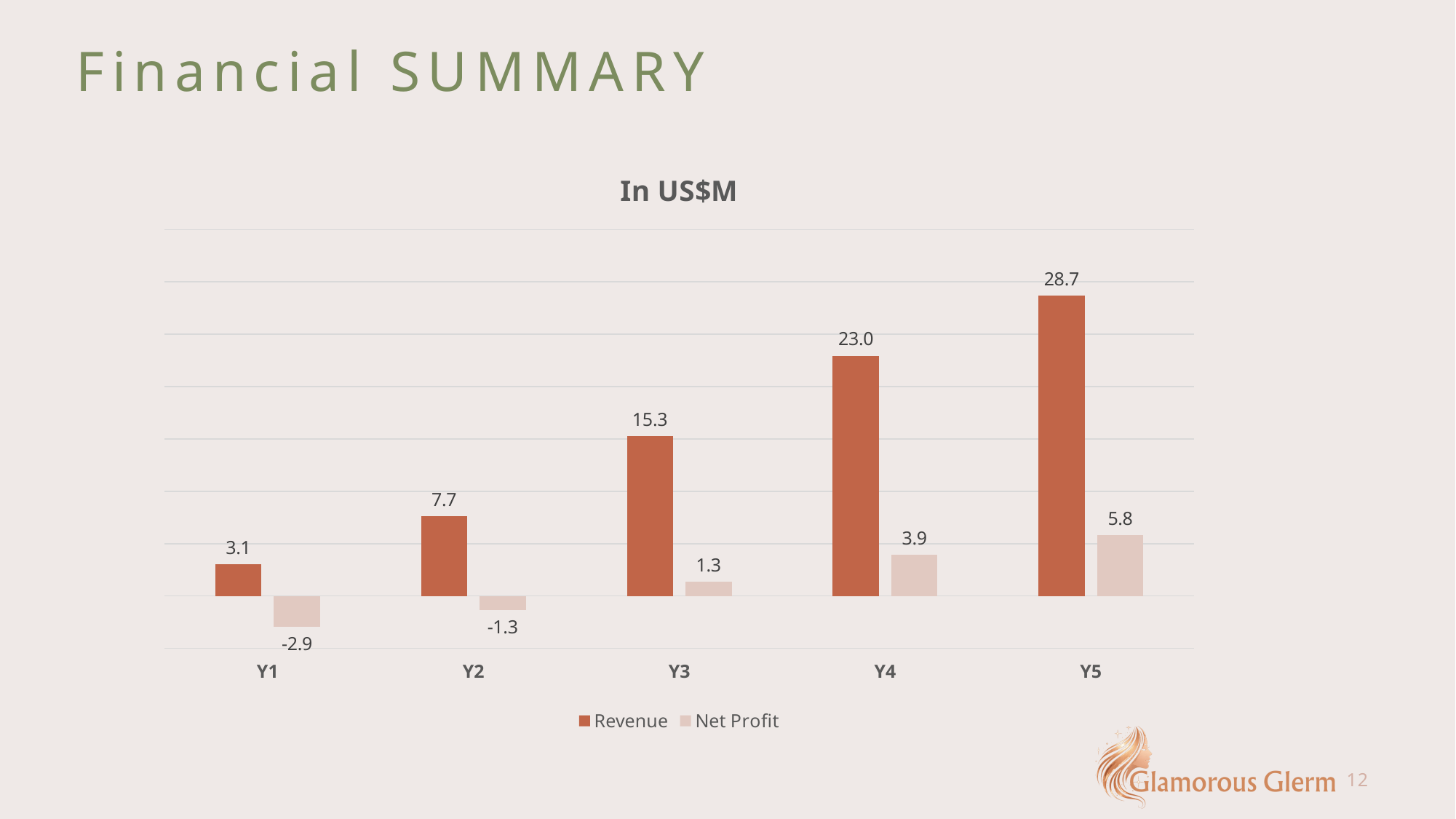
Which year has the lowest Net Profit? Y1 What is the title of the chart? In US$M How many series does the legend list? 2 What is the Net Profit value for Y1? -2.9 Does Revenue rise or fall from Y1 to Y5? Rise What kind of chart is shown on the slide? Bar chart What is the Revenue value for Y3? 15.3 What is the difference between Revenue in Y5 and Revenue in Y4? 5.7 Which year has the highest Revenue? Y5 Which is larger, Net Profit in Y3 or Net Profit in Y4? Net Profit in Y4 What is the Net Profit value for Y5? 5.8 How many years are shown on the x axis? 5